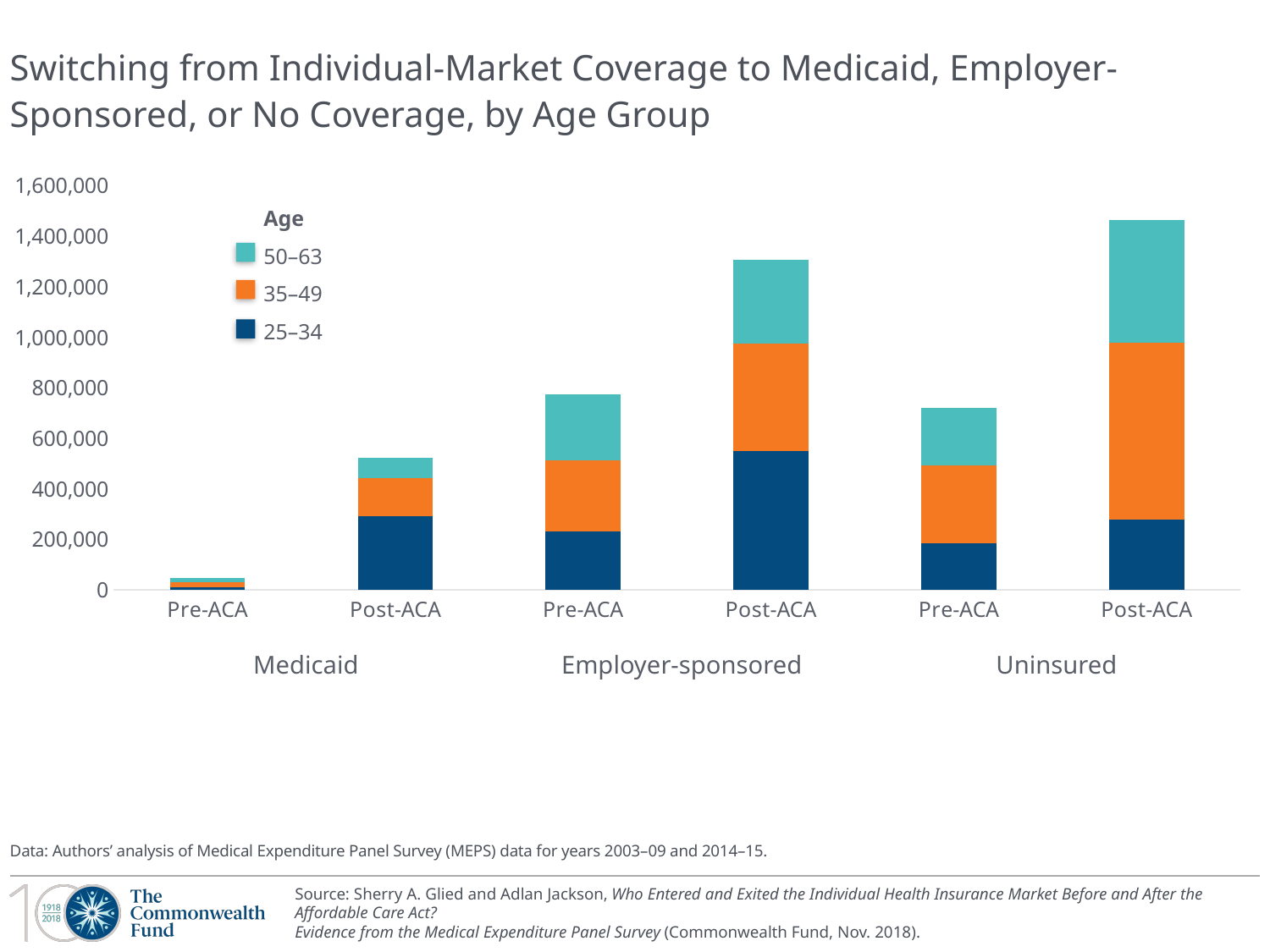
What are the three coverage categories labeled along the x axis? Medicaid, Employer-sponsored, Uninsured Which is larger: the total for Medicaid Post-ACA or the total for Employer-sponsored Pre-ACA? Employer-sponsored Pre-ACA Which age group is shown in dark blue in the legend? 25–34 For the Uninsured group, is the Post-ACA bar higher or lower than the Pre-ACA bar? higher Is the total for Medicaid Post-ACA greater or less than 600,000? less Is the total for Uninsured Pre-ACA greater or less than 800,000? less How many bars are plotted in the chart? 6 What kind of chart is shown on the slide? Stacked bar chart Which bar has the lowest total value? Medicaid Pre-ACA Is the total for Employer-sponsored Post-ACA greater or less than 1,200,000? greater How many age groups does the legend list? 3 Which bar has the highest total value? Uninsured Post-ACA